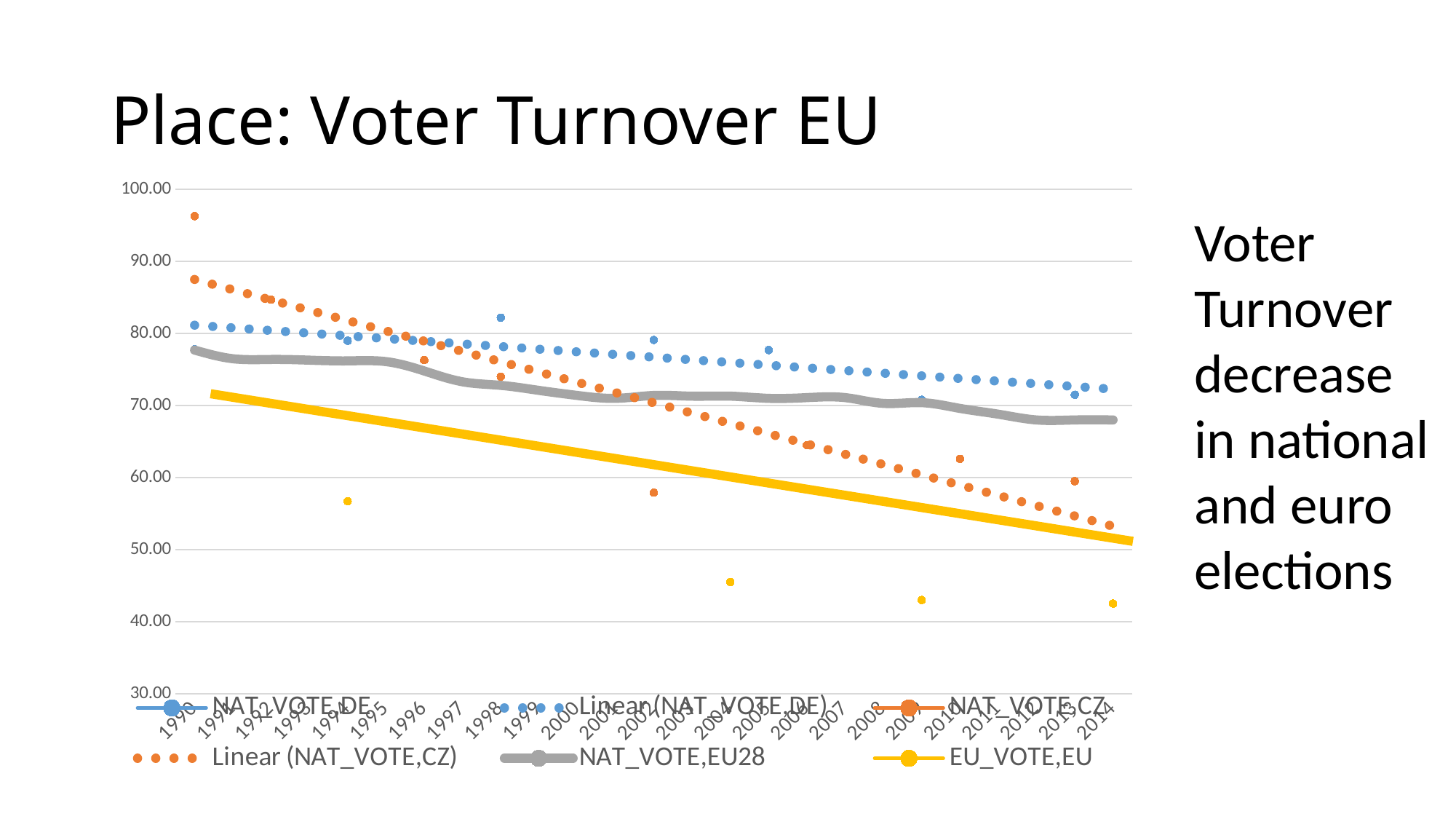
How many series does the chart legend list? 6 Does the NAT_VOTE,EU28 series rise or fall from 1990 to 2014? fall Is the value for EU_VOTE,EU in 2014 greater or less than 50.00? less What kind of chart is shown on the slide? line chart Is the value for NAT_VOTE,EU28 in 2014 greater or less than 70.00? less Does the EU_VOTE,EU trend line rise or fall along the x axis? fall Is the value for NAT_VOTE,CZ in 1990 greater or less than 90.00? greater What is the title of the slide containing the chart? Place: Voter Turnover EU What colour is the EU_VOTE,EU series in the chart? yellow In 1990, which is higher: NAT_VOTE,CZ or NAT_VOTE,DE? NAT_VOTE,CZ Does the Linear (NAT_VOTE,CZ) trend line rise or fall along the x axis? fall